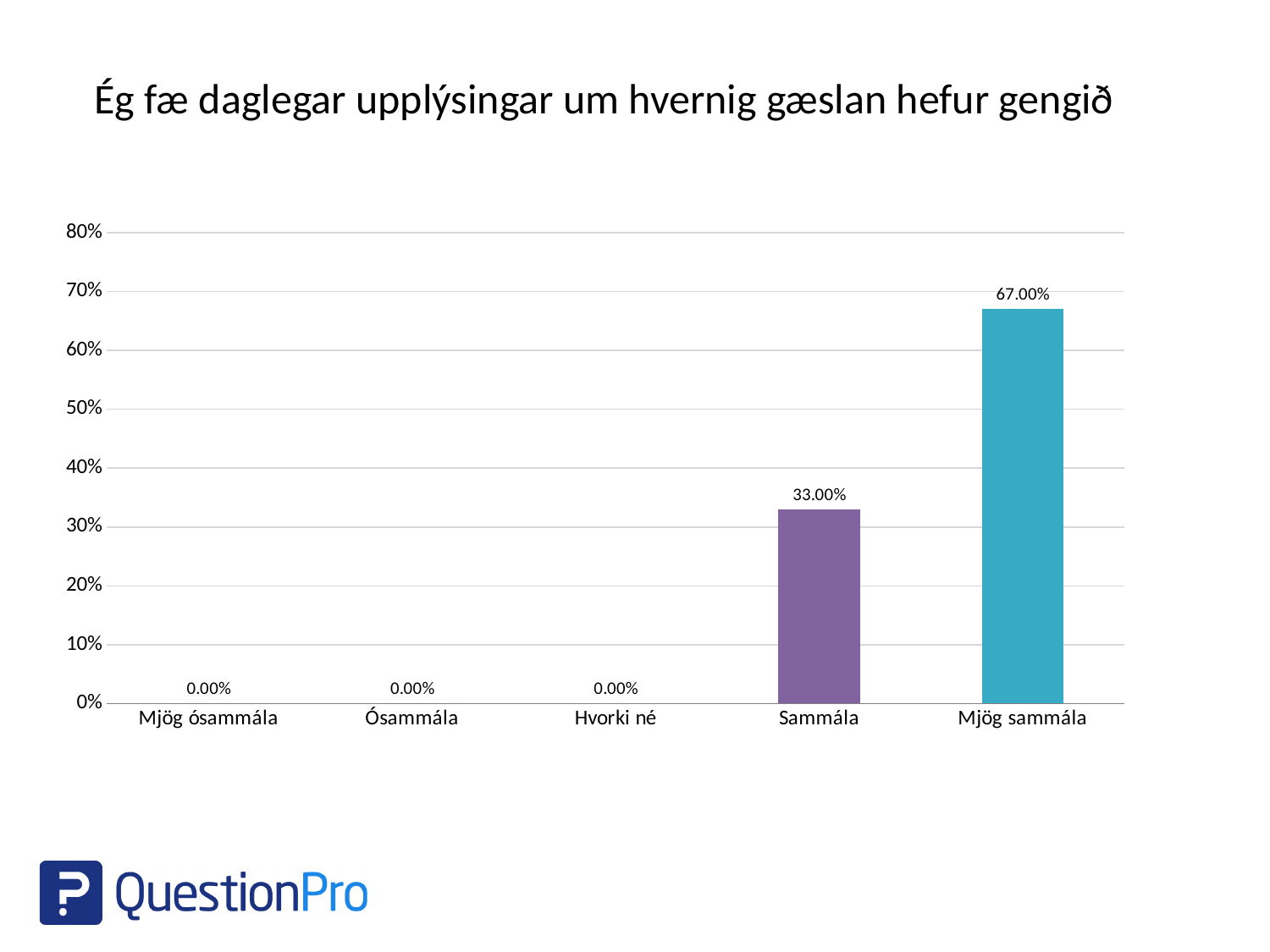
What kind of chart is shown on the slide? bar chart What is the difference between the values for Mjög sammála and Sammála? 34.00% How many categories have a value of 0.00%? 3 How many categories are shown on the x axis? 5 What is the value for Mjög sammála? 67.00% Which is larger, the value for Sammála or the value for Mjög sammála? Mjög sammála Is the value for Sammála greater or less than 40%? less What is the title of the chart? Ég fæ daglegar upplýsingar um hvernig gæslan hefur gengið What is the value for Hvorki né? 0.00% Is the value for Mjög sammála greater or less than 60%? greater What is the value for Sammála? 33.00% Which category has the highest value? Mjög sammála